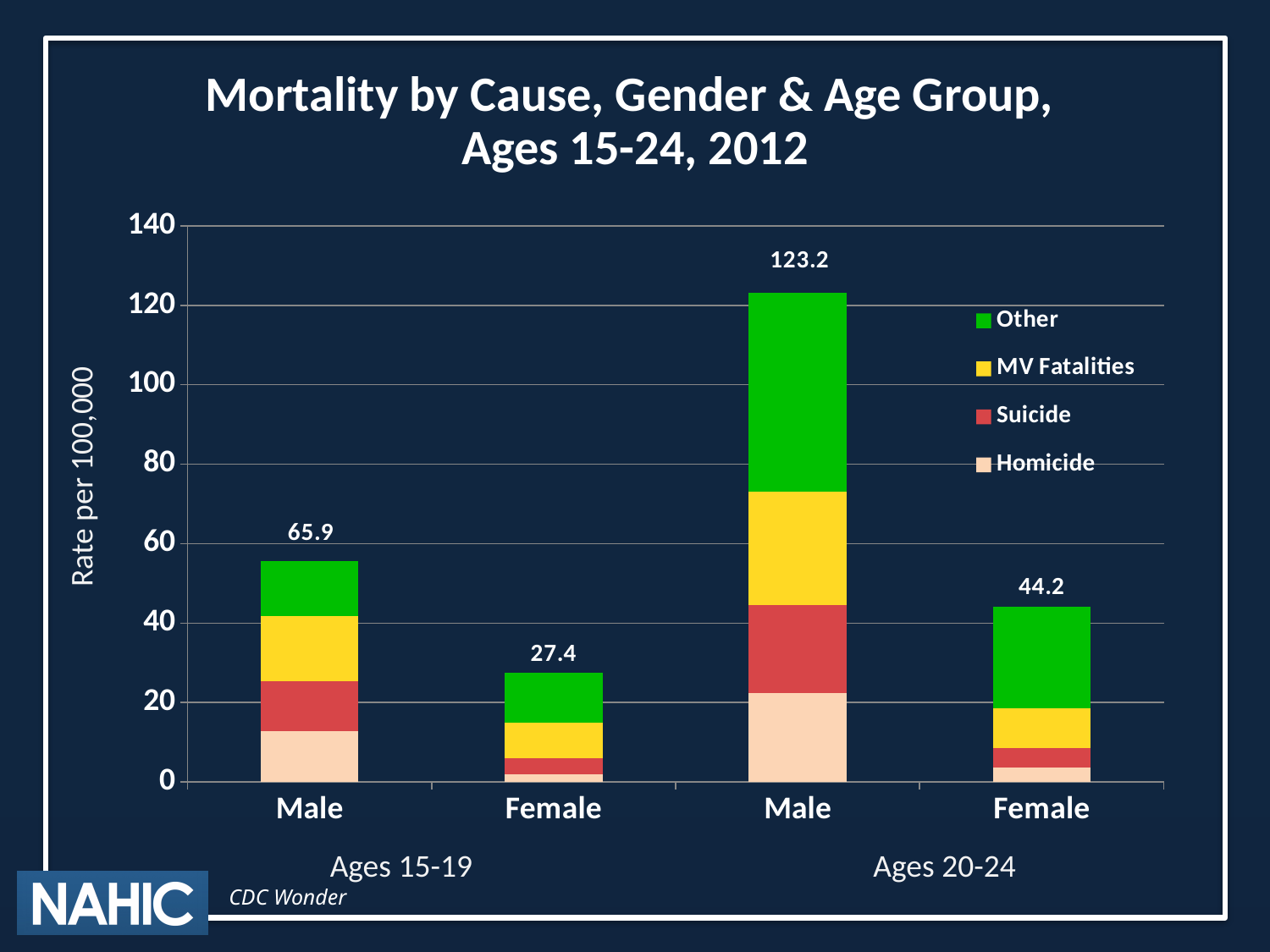
What is the total mortality rate labeled for females ages 15-19? 27.4 What type of chart is shown on the slide? stacked bar chart What is the label of the y axis? Rate per 100,000 How many bars are plotted on the chart? 4 How many series does the legend list? 4 Which bar has the lowest total mortality rate? Female, Ages 15-19 What is the difference between the labeled totals for males ages 20-24 and females ages 20-24? 79.0 Is the Homicide value for males ages 20-24 greater or less than 20? greater Which is larger, the labeled total for males ages 15-19 or females ages 20-24? Male, Ages 15-19 What is the total mortality rate labeled for males ages 20-24? 123.2 What is the total mortality rate labeled for females ages 20-24? 44.2 Which bar has the highest total mortality rate? Male, Ages 20-24